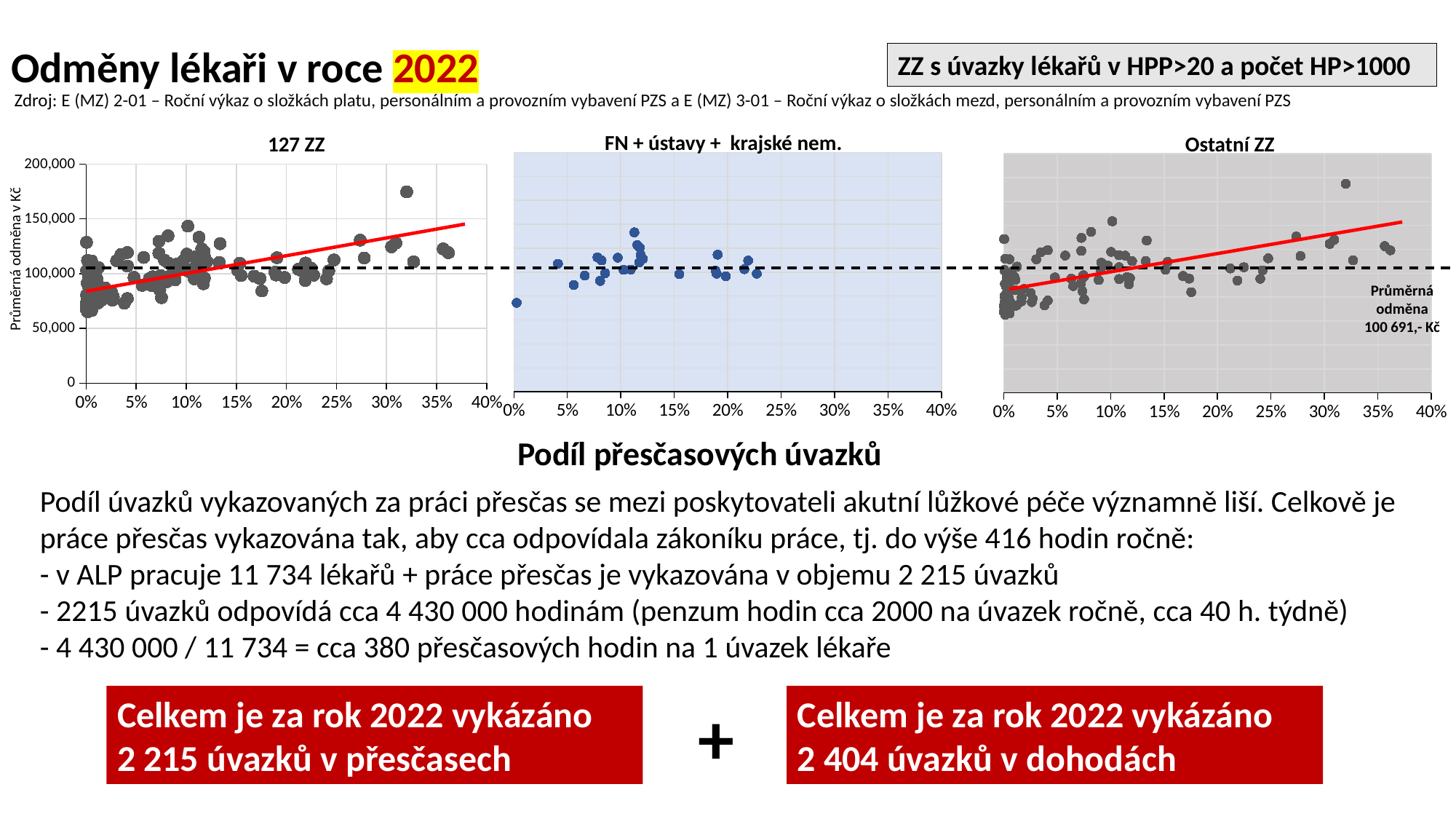
How many charts are shown on the slide? 3 What is the title of the middle chart? FN + ústavy + krajské nem. What average reward value (Průměrná odměna) is printed on the chart titled "Ostatní ZZ"? 100 691,- Kč In the chart titled "Ostatní ZZ", is the highest plotted point greater or less than 150,000? greater In the chart titled "127 ZZ", does the red trend line rise or fall as the share of overtime contracts increases? rises What is the maximum value shown on the vertical axis of the chart titled "127 ZZ"? 200,000 What kind of chart is the chart titled "127 ZZ"? scatter chart What is the label of the vertical axis on the left chart? Průměrná odměna v Kč In the chart titled "FN + ústavy + krajské nem.", is the highest plotted point greater or less than 150,000? less In the chart titled "127 ZZ", is the highest plotted point greater or less than 150,000? greater In the chart titled "Ostatní ZZ", does the red trend line rise or fall along the x axis? rises